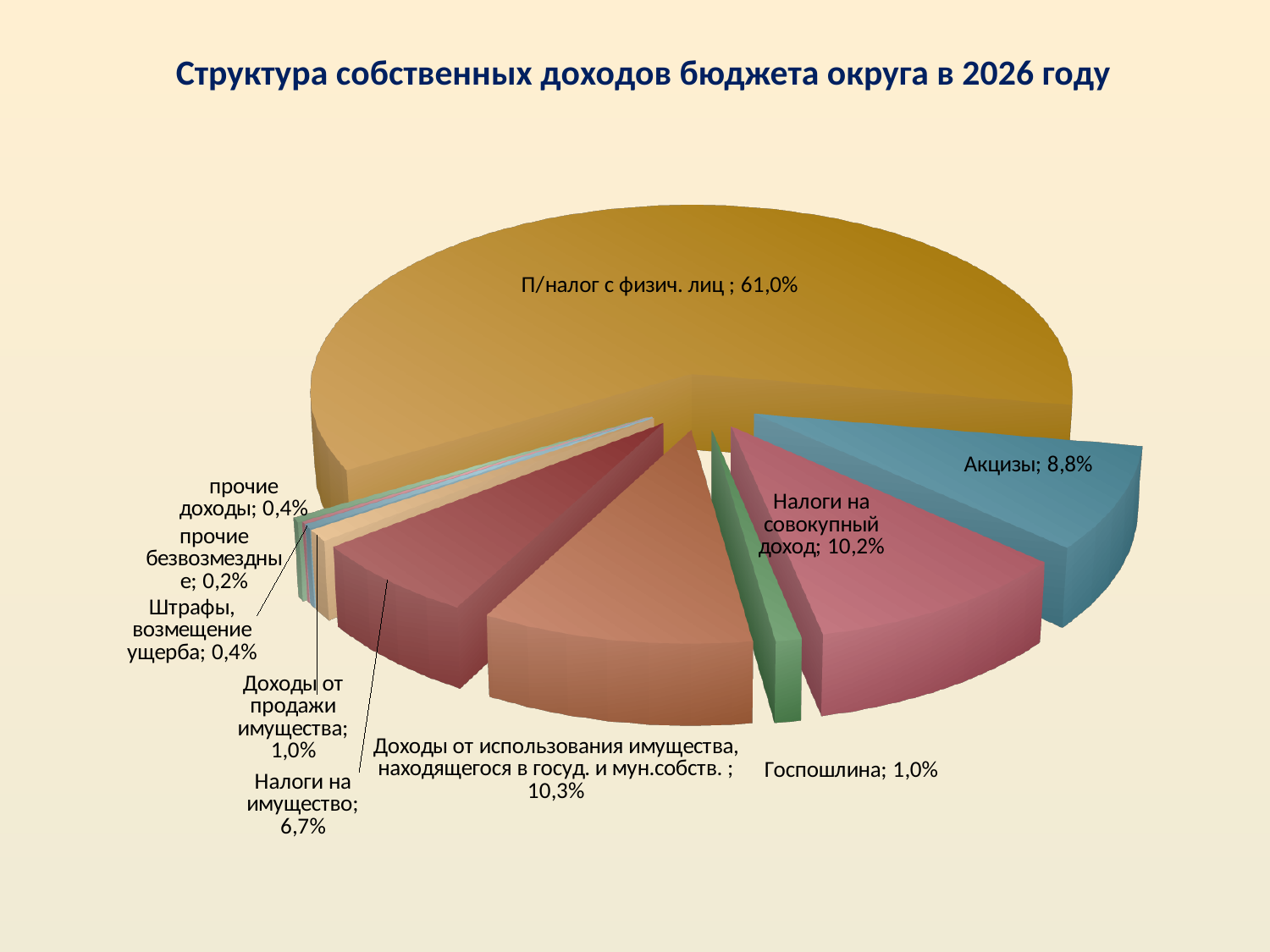
What is the value shown for "Доходы от использования имущества, находящегося в госуд. и мун.собств."? 10,3% What share of the pie does "П/налог с физич. лиц" represent? 61,0% What is the value shown for "Налоги на имущество"? 6,7% How many categories (slices) does the pie chart show? 10 What is the difference between the shares of "Акцизы" and "Налоги на имущество"? 2,1 percentage points Which category has the smallest share of the pie? прочие безвозмездные What type of chart is shown on the slide? Pie chart What is the value shown for "Акцизы"? 8,8% What is the value shown for "Налоги на совокупный доход"? 10,2% Which category has the largest share of the pie? П/налог с физич. лиц What is the difference between the shares of "П/налог с физич. лиц" and "Акцизы"? 52,2 percentage points Which is larger: the share of "Акцизы" or the share of "Налоги на имущество"? Акцизы